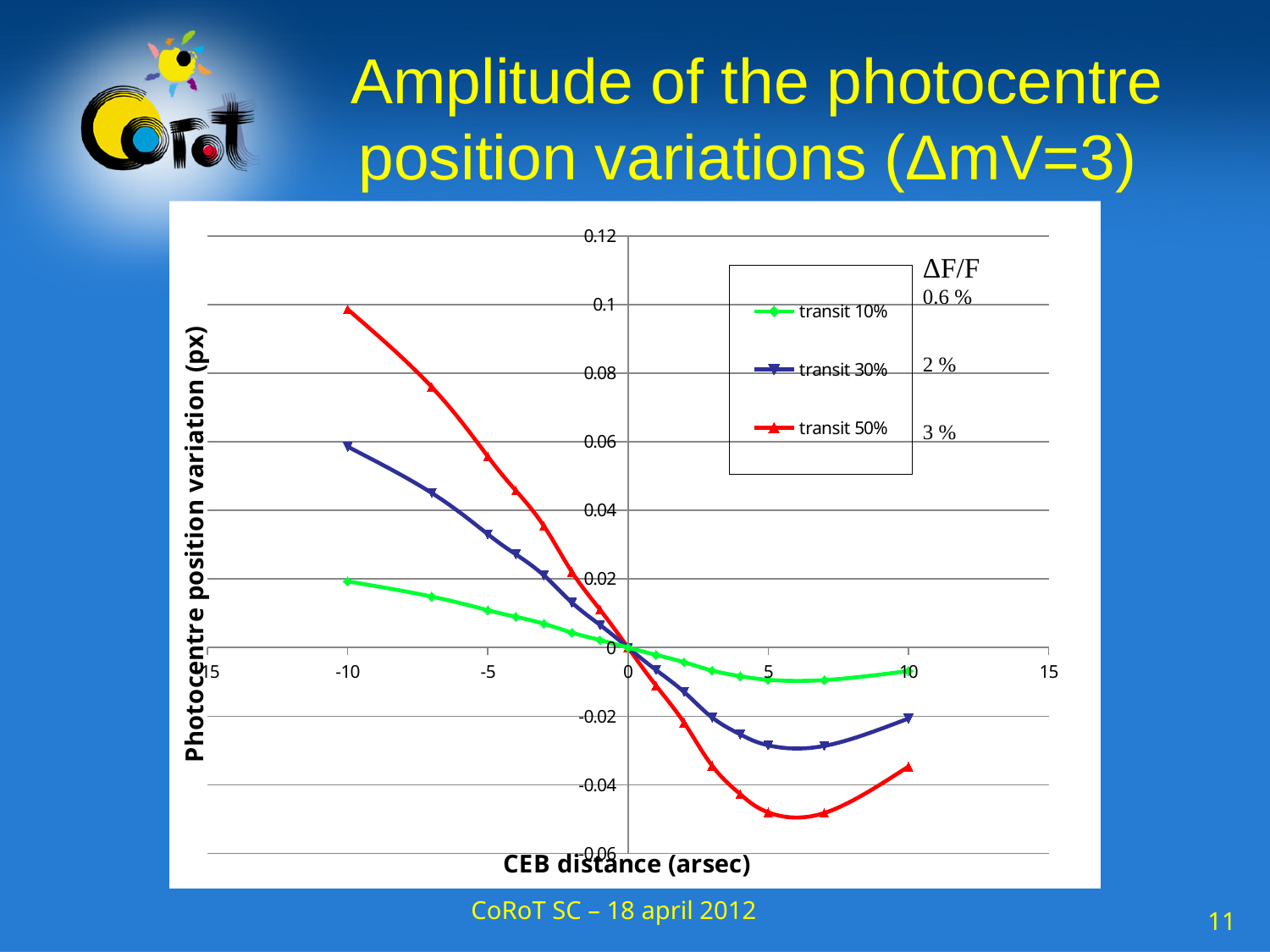
What kind of chart is shown on the slide? line chart What are the three series named in the legend? transit 10%, transit 30%, transit 50% How many series does the legend list? 3 Is the value of the transit 30% series at CEB distance -10 greater or less than 0.04? greater What is the title of the x axis? CEB distance (arsec) Is the value of the transit 50% series at CEB distance -10 greater or less than 0.08? greater At CEB distance -10, which series has the higher value, transit 50% or transit 10%? transit 50% Is the lowest value of the transit 50% series greater or less than -0.04? less Which series reaches the highest photocentre position variation on the chart? transit 50% Which series reaches the lowest (most negative) photocentre position variation on the chart? transit 50% Does the transit 50% series rise or fall as CEB distance goes from -10 to 5? fall